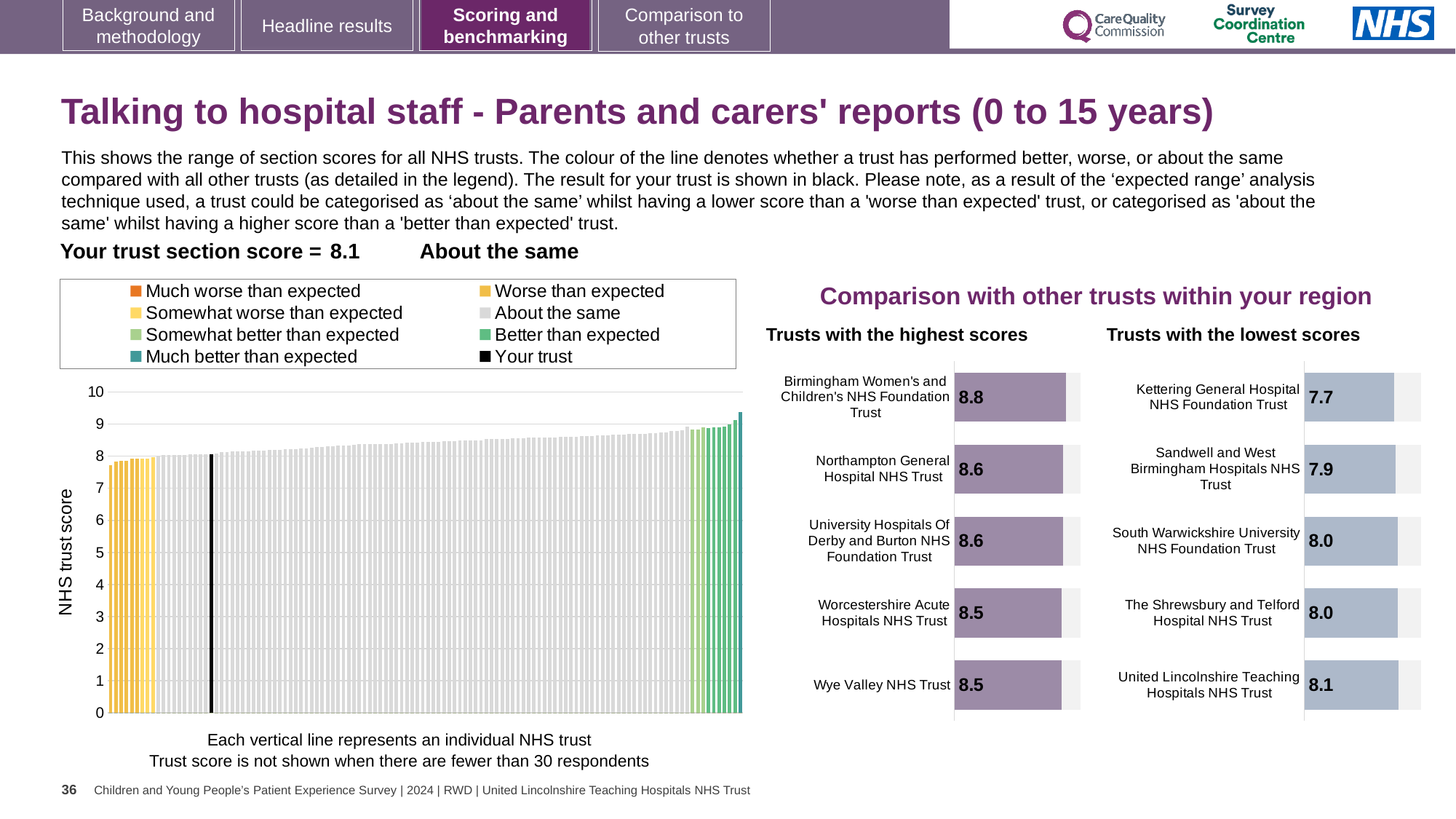
What kind of chart is the large chart on the left with the 'NHS trust score' axis? Bar chart In the 'Trusts with the lowest scores' chart, what is the difference between the scores of United Lincolnshire Teaching Hospitals NHS Trust and Kettering General Hospital NHS Foundation Trust? 0.4 In the 'Trusts with the lowest scores' chart, which has the larger score: Sandwell and West Birmingham Hospitals NHS Trust or Kettering General Hospital NHS Foundation Trust? Sandwell and West Birmingham Hospitals NHS Trust In the 'Trusts with the lowest scores' chart, what is the score for Kettering General Hospital NHS Foundation Trust? 7.7 In the large 'NHS trust score' chart on the left, do the bar values rise or fall from left to right? Rise In the 'Trusts with the highest scores' chart, which trust has the highest score? Birmingham Women's and Children's NHS Foundation Trust In the 'Trusts with the highest scores' chart, how many trusts are shown? 5 How many entries does the legend above the 'NHS trust score' chart list? 8 In the 'Trusts with the highest scores' chart, what is the difference between the scores of Birmingham Women's and Children's NHS Foundation Trust and Wye Valley NHS Trust? 0.3 In the 'Trusts with the lowest scores' chart, which trust has the lowest score? Kettering General Hospital NHS Foundation Trust In the 'Trusts with the highest scores' chart, what is the score for Birmingham Women's and Children's NHS Foundation Trust? 8.8 In the large 'NHS trust score' chart on the left, is the value of the leftmost bar greater or less than 8? less